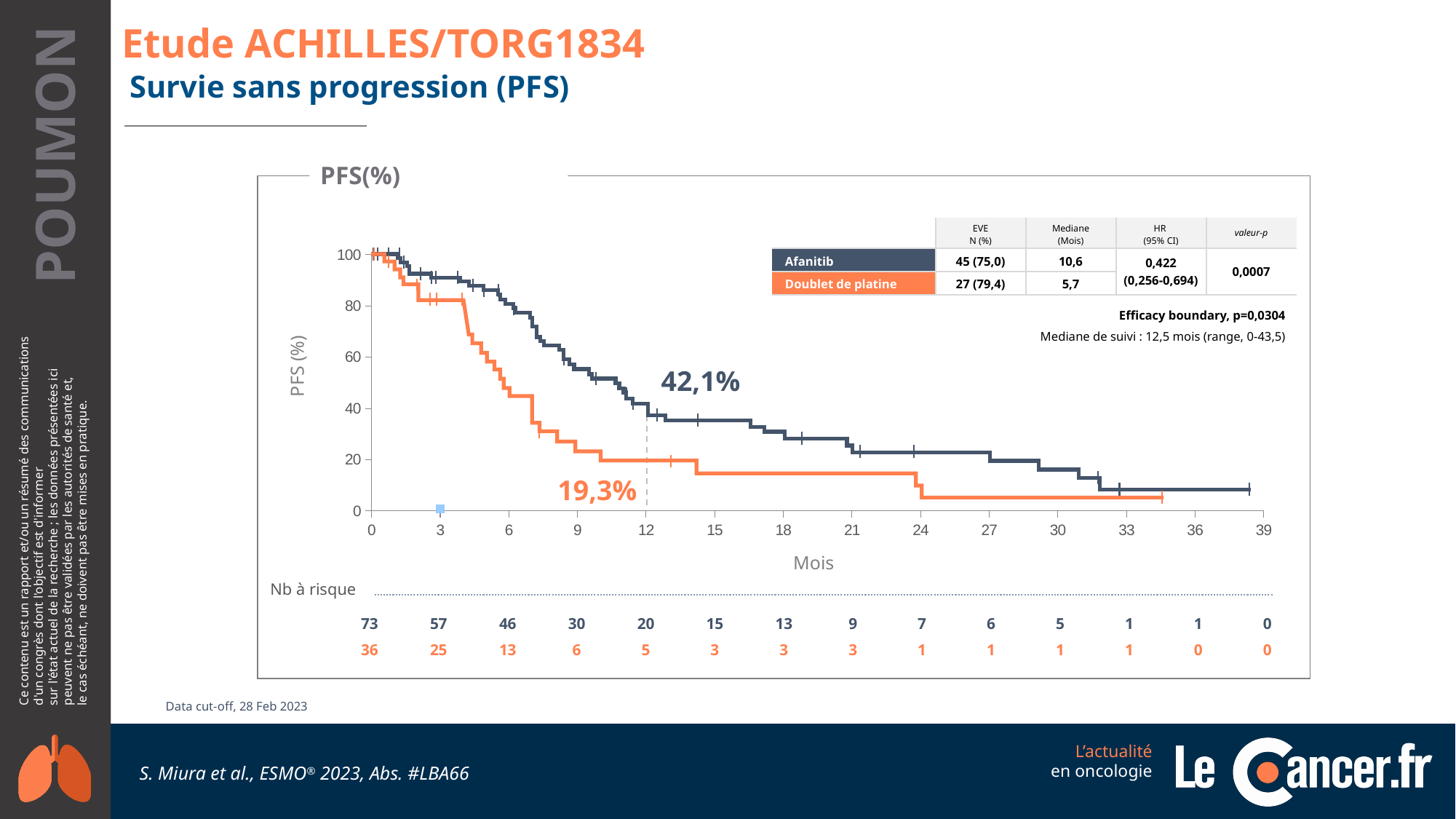
What is the label of the x axis of the chart? Mois How many series (treatment arms) are plotted on the chart? 2 What is the median PFS in months for the Doublet de platine arm? 5,7 What is the hazard ratio (95% CI) shown on the chart? 0,422 (0,256-0,694) What is the difference in 12-month PFS between the Afanitib and Doublet de platine arms? 22,8% How many patients were at risk in the Doublet de platine arm at 6 months? 13 Which arm has the higher PFS at 12 months, Afanitib or Doublet de platine? Afanitib What is the median PFS in months for the Afanitib arm? 10,6 What is the PFS rate at 12 months for the Doublet de platine arm? 19,3% What is the PFS rate at 12 months for the Afanitib arm? 42,1% What kind of chart is shown on the slide? Kaplan-Meier survival curve (line chart) How many patients were at risk in the Afanitib arm at 0 months? 73